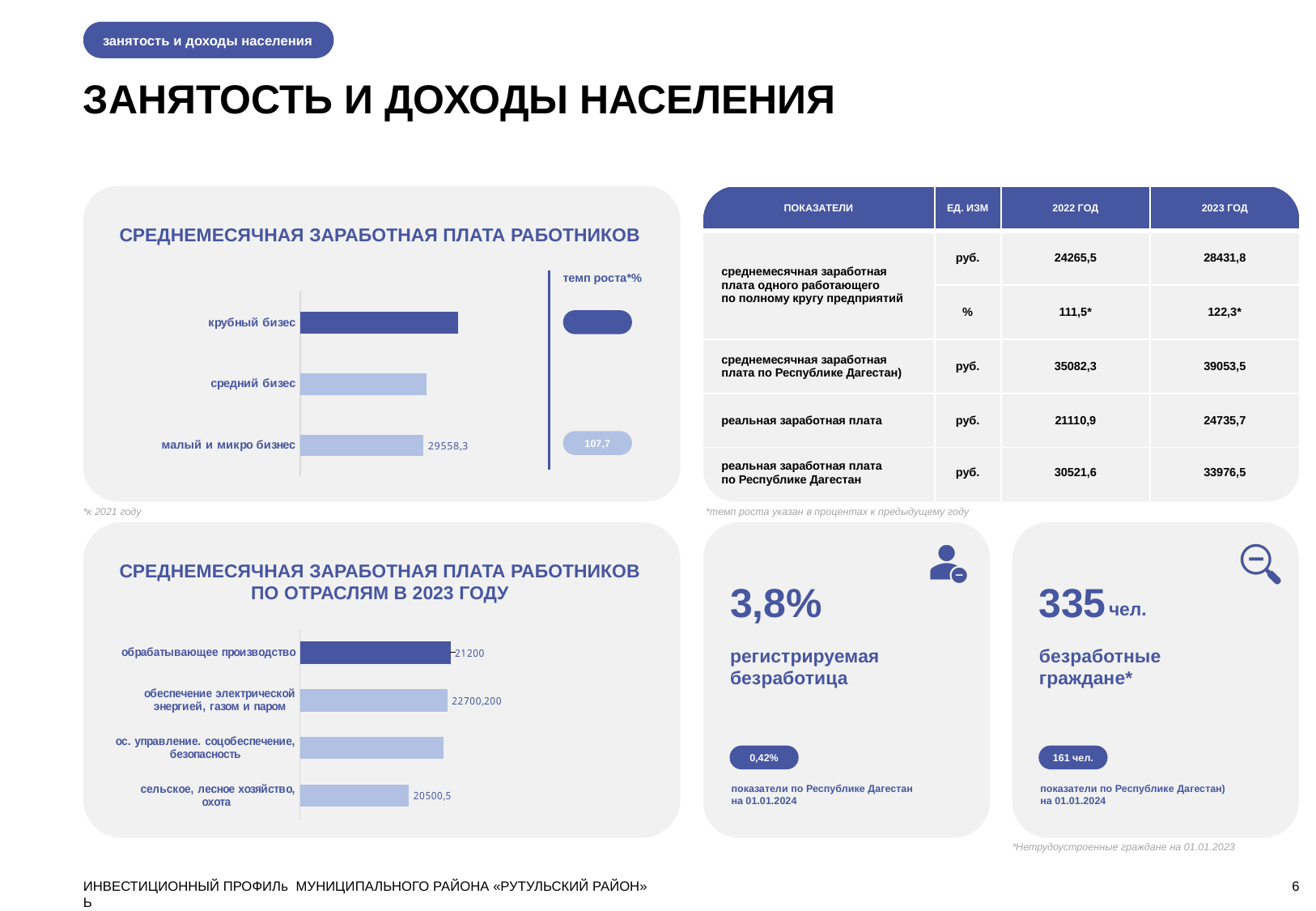
What type of chart is 'СРЕДНЕМЕСЯЧНАЯ ЗАРАБОТНАЯ ПЛАТА РАБОТНИКОВ'? bar chart On the chart 'СРЕДНЕМЕСЯЧНАЯ ЗАРАБОТНАЯ ПЛАТА РАБОТНИКОВ', which category has the longest bar? крубный бизес On the chart 'СРЕДНЕМЕСЯЧНАЯ ЗАРАБОТНАЯ ПЛАТА РАБОТНИКОВ ПО ОТРАСЛЯМ В 2023 ГОДУ', which is larger: the value for 'обрабатывающее производство' or for 'сельское, лесное хозяйство, охота'? обрабатывающее производство How many categories are shown on the chart 'СРЕДНЕМЕСЯЧНАЯ ЗАРАБОТНАЯ ПЛАТА РАБОТНИКОВ'? 3 On the chart 'СРЕДНЕМЕСЯЧНАЯ ЗАРАБОТНАЯ ПЛАТА РАБОТНИКОВ', what is the value shown for 'малый и микро бизнес'? 29558,3 On the chart 'СРЕДНЕМЕСЯЧНАЯ ЗАРАБОТНАЯ ПЛАТА РАБОТНИКОВ ПО ОТРАСЛЯМ В 2023 ГОДУ', what is the value for 'сельское, лесное хозяйство, охота'? 20500,5 On the chart 'СРЕДНЕМЕСЯЧНАЯ ЗАРАБОТНАЯ ПЛАТА РАБОТНИКОВ ПО ОТРАСЛЯМ В 2023 ГОДУ', what is the value for 'обрабатывающее производство'? 21200 How many categories are shown on the chart 'СРЕДНЕМЕСЯЧНАЯ ЗАРАБОТНАЯ ПЛАТА РАБОТНИКОВ ПО ОТРАСЛЯМ В 2023 ГОДУ'? 4 On the chart 'СРЕДНЕМЕСЯЧНАЯ ЗАРАБОТНАЯ ПЛАТА РАБОТНИКОВ ПО ОТРАСЛЯМ В 2023 ГОДУ', which category has the shortest bar? сельское, лесное хозяйство, охота On the chart 'СРЕДНЕМЕСЯЧНАЯ ЗАРАБОТНАЯ ПЛАТА РАБОТНИКОВ', what growth rate (темп роста) is shown for 'малый и микро бизнес'? 107,7 On the chart 'СРЕДНЕМЕСЯЧНАЯ ЗАРАБОТНАЯ ПЛАТА РАБОТНИКОВ ПО ОТРАСЛЯМ В 2023 ГОДУ', what is the difference between the values for 'обрабатывающее производство' and 'сельское, лесное хозяйство, охота'? 699,5 On the chart 'СРЕДНЕМЕСЯЧНАЯ ЗАРАБОТНАЯ ПЛАТА РАБОТНИКОВ ПО ОТРАСЛЯМ В 2023 ГОДУ', what is the value for 'обеспечение электрической энергией, газом и паром'? 22700,200